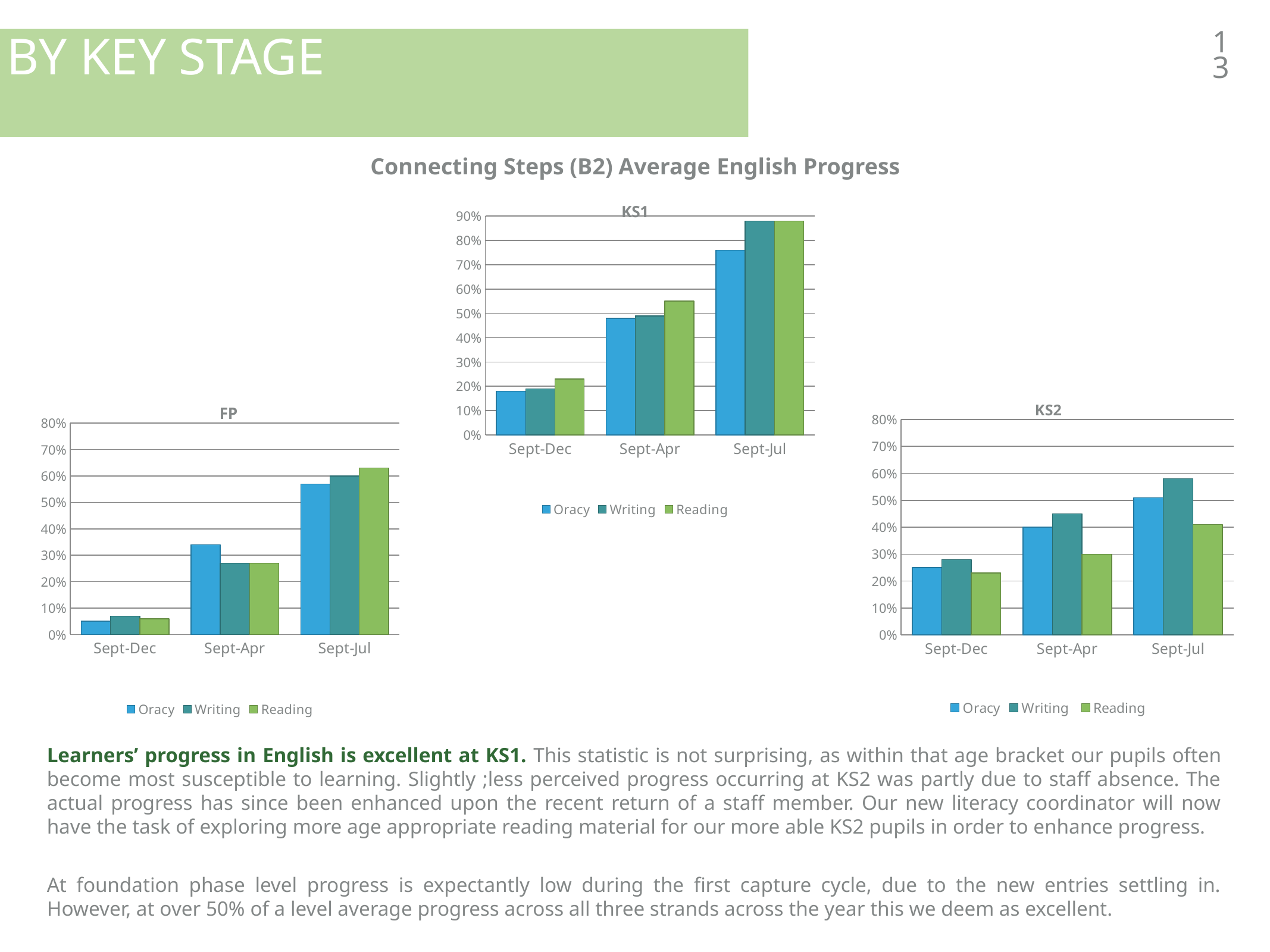
In the FP chart, for Sept-Jul, which is larger: Reading or Oracy? Reading In the KS2 chart, how many categories are shown on the x axis? 3 What kind of chart is the FP chart? bar chart In the KS1 chart, do the Oracy values rise or fall from Sept-Dec to Sept-Jul? rise What is the overall title shown above the three charts? Connecting Steps (B2) Average English Progress In the FP chart, which series has the highest value for Sept-Apr? Oracy In the KS2 chart, for Sept-Jul, which is larger: Writing or Reading? Writing In the KS1 chart, is the Reading value for Sept-Jul greater or less than 80%? greater In the KS2 chart, which series has the lowest value for Sept-Jul? Reading In the FP chart, is the Oracy value for Sept-Dec greater or less than 10%? less In the KS2 chart, is the Reading value for Sept-Apr greater or less than 40%? less In the KS1 chart, how many series does the legend list? 3